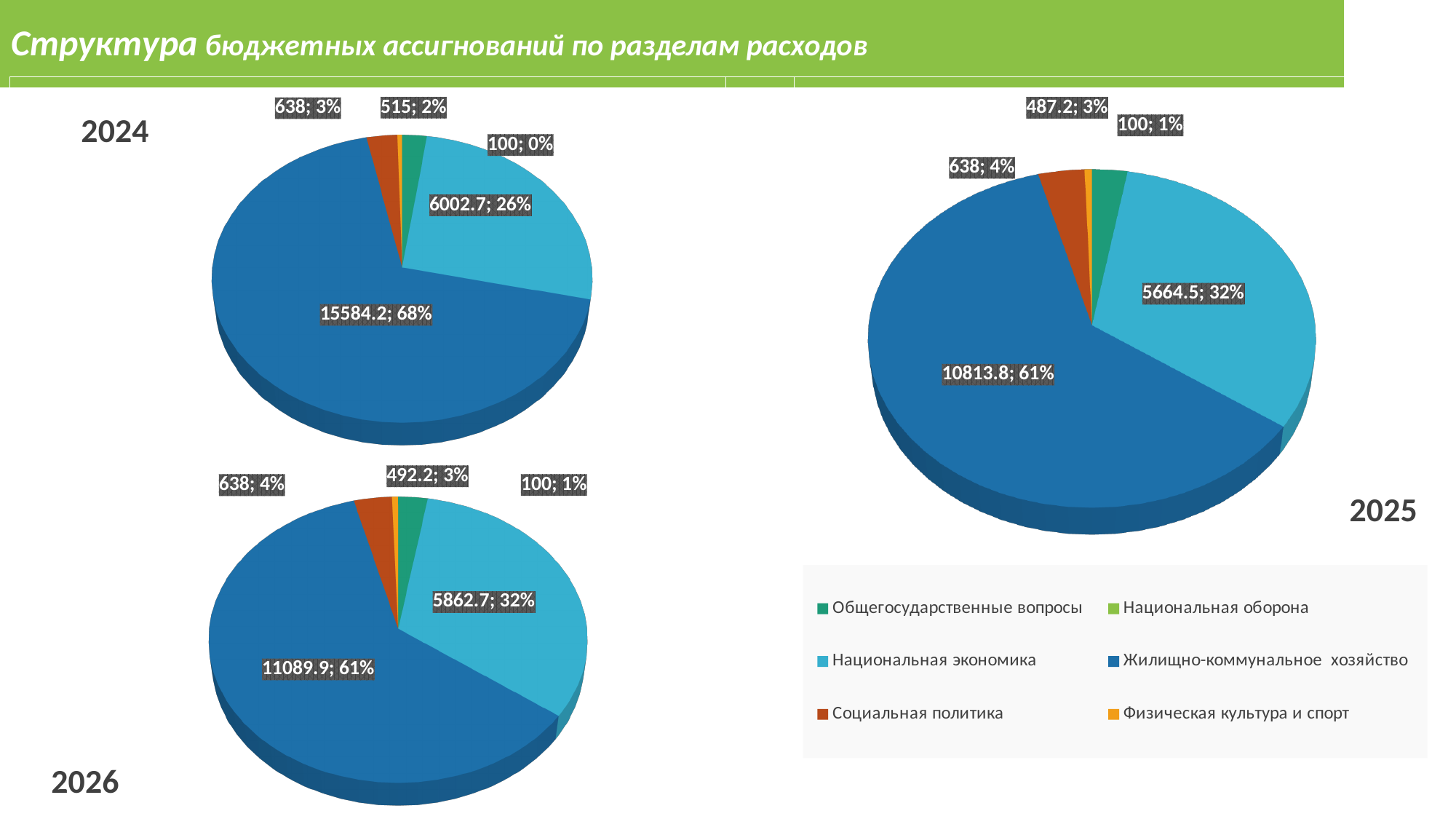
In the 2025 pie chart, what is the value shown for Социальная политика? 638 In the 2025 pie chart, what share of the total does Жилищно-коммунальное хозяйство have? 61% In the 2024 pie chart, what is the difference between the values for Жилищно-коммунальное хозяйство and Национальная экономика? 9581.5 In the 2024 pie chart, what share of the total does Национальная экономика have? 26% What kind of chart is used for the 2024 data? Pie chart In the 2026 pie chart, what is the value shown for Жилищно-коммунальное хозяйство? 11089.9 In the 2024 pie chart, what is the value shown for Жилищно-коммунальное хозяйство? 15584.2 Is the value for Национальная экономика larger in the 2025 pie chart or in the 2026 pie chart? 2026 In the 2026 pie chart, what share of the total does Социальная политика have? 4% In the 2025 pie chart, what is the value shown for Национальная экономика? 5664.5 How many categories does the legend list? 6 In the 2026 pie chart, which category has the largest slice? Жилищно-коммунальное хозяйство